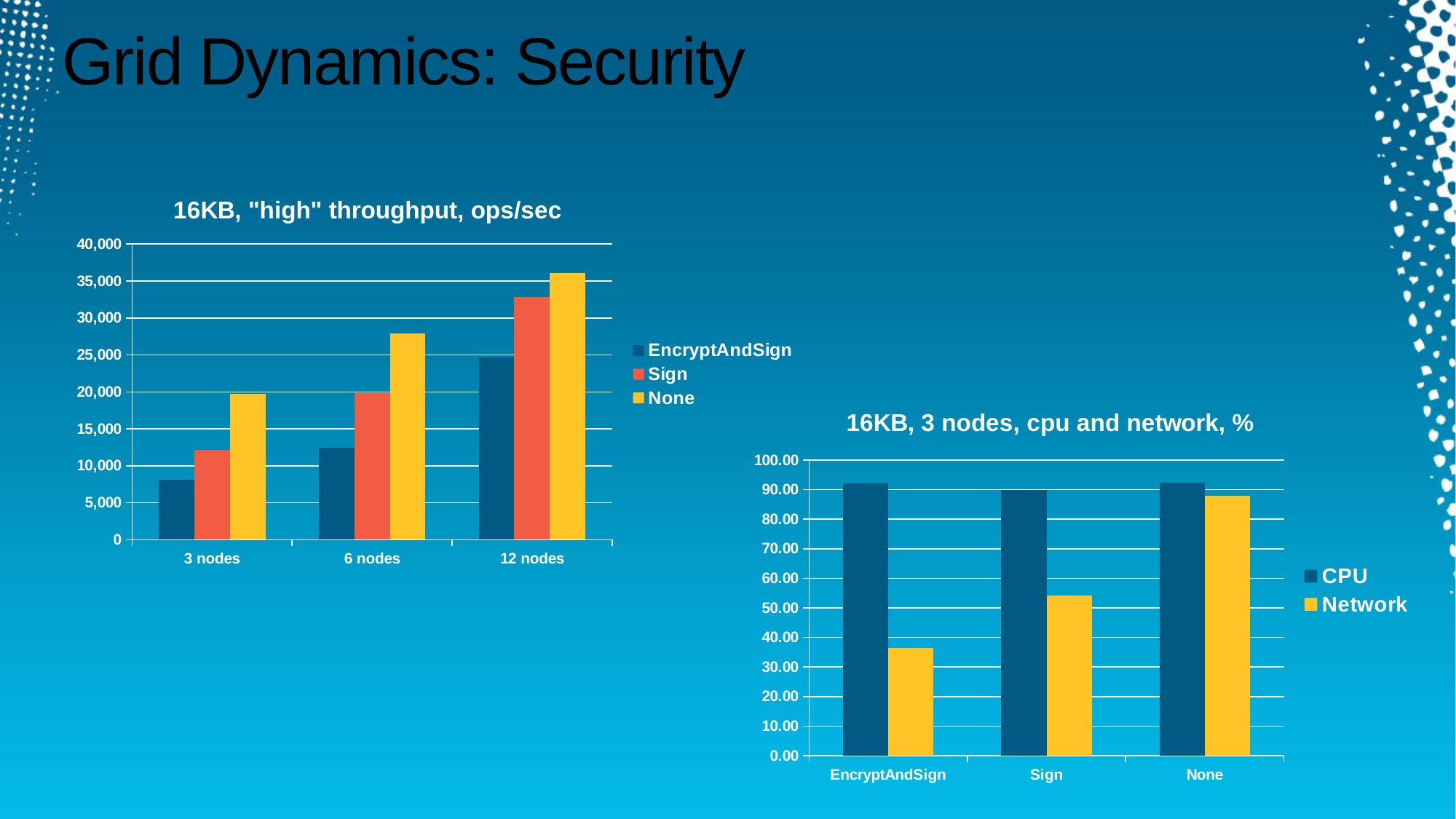
In the "16KB, "high" throughput, ops/sec" chart, which category has the highest None bar? 12 nodes What kind of chart is the "16KB, "high" throughput, ops/sec" chart? bar chart In the "16KB, 3 nodes, cpu and network, %" chart, what colour are the Network bars? yellow How many series does the legend of the "16KB, 3 nodes, cpu and network, %" chart list? 2 In the "16KB, "high" throughput, ops/sec" chart, which is larger for 6 nodes: Sign or EncryptAndSign? Sign How many node-count categories are shown on the x axis of the "16KB, "high" throughput, ops/sec" chart? 3 In the "16KB, "high" throughput, ops/sec" chart, do the None values rise or fall as the number of nodes increases? rise In the "16KB, "high" throughput, ops/sec" chart, is the EncryptAndSign value for 3 nodes greater or less than 10,000? less In the "16KB, 3 nodes, cpu and network, %" chart, which category has the lowest Network value? EncryptAndSign In the "16KB, "high" throughput, ops/sec" chart, is the None value for 12 nodes greater or less than 35,000? greater How many series does the legend of the "16KB, "high" throughput, ops/sec" chart list? 3 In the "16KB, 3 nodes, cpu and network, %" chart, is the Network value for Sign greater or less than 50.00? greater